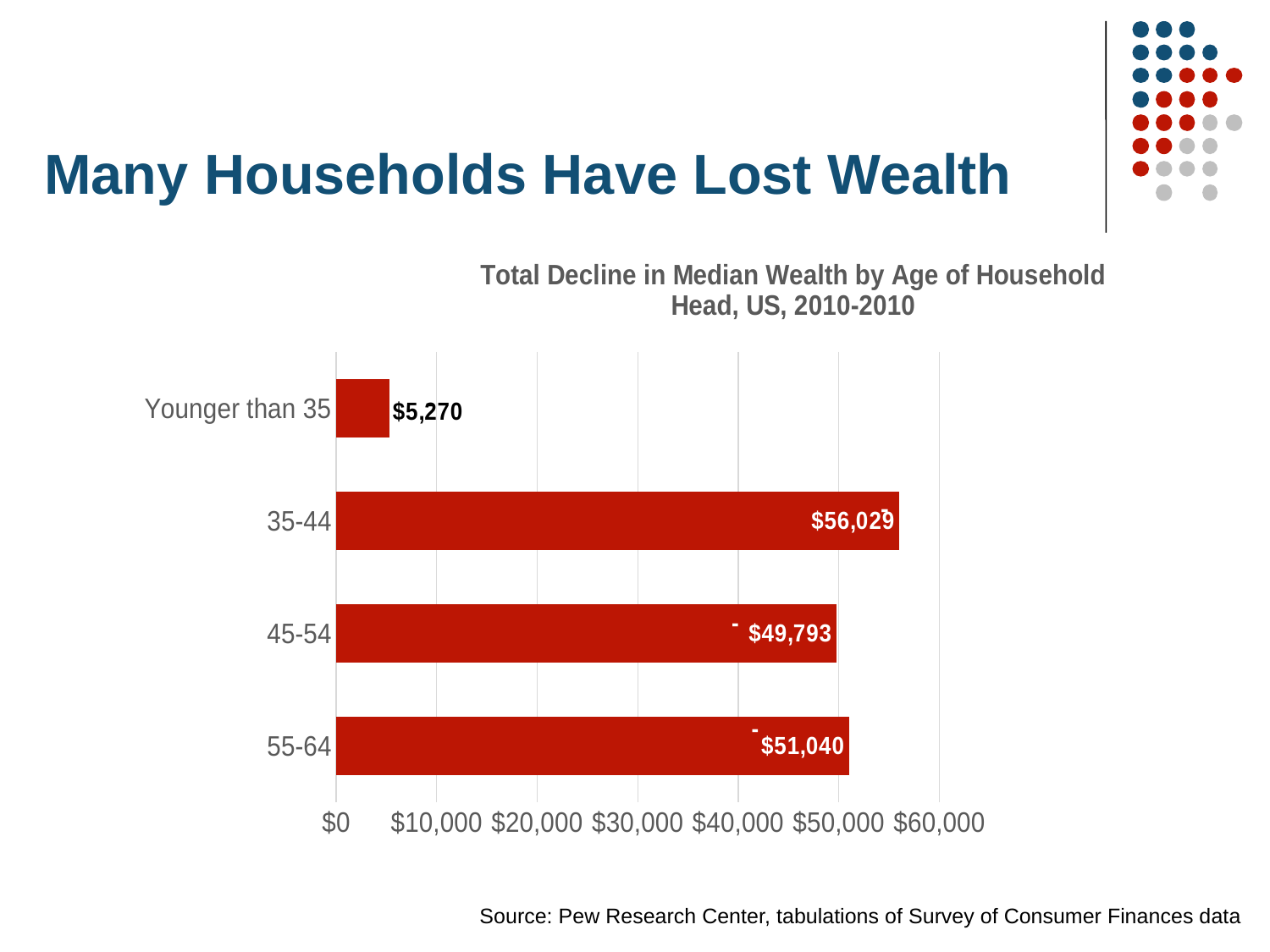
Which age group has the largest decline in median wealth? 35-44 What is the value shown for the 45-54 age group? $49,793 How many age groups are shown in the chart? 4 Is the value for the 35-44 age group greater or less than $50,000? greater Which has the larger decline in median wealth, the 55-64 group or the 45-54 group? 55-64 What is the value shown for the 55-64 age group? $51,040 What is the difference between the values for the 55-64 and 45-54 age groups? $1,247 Which age group has the smallest decline in median wealth? Younger than 35 What is the value shown for the 35-44 age group? $56,029 What type of chart is shown on the slide? Bar chart What is the total decline in median wealth for households headed by someone younger than 35? $5,270 What is the difference between the values for the 55-64 group and the Younger than 35 group? $45,770